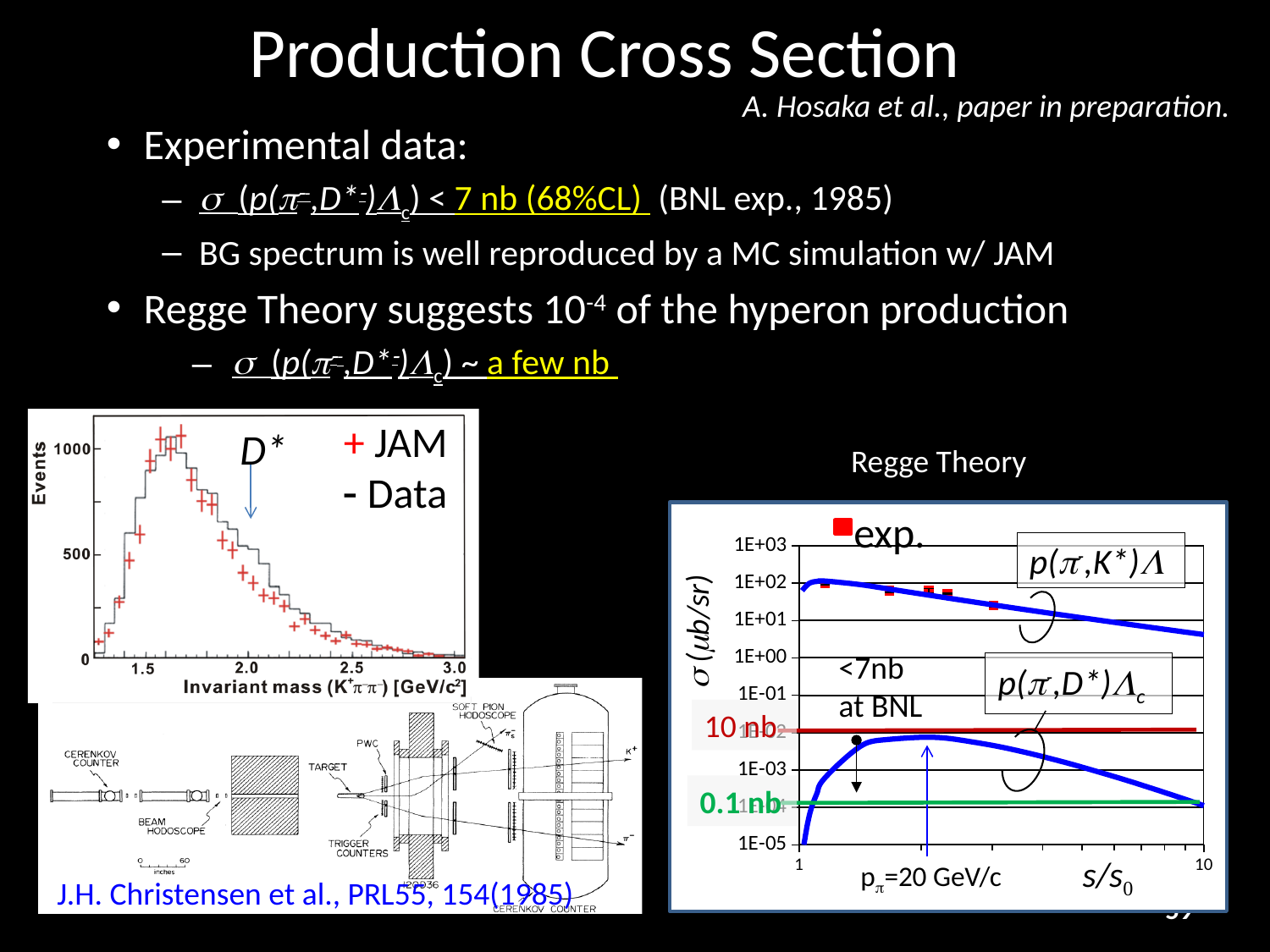
In the Regge Theory chart, which curve lies higher, p(π,K*)Λ or p(π,D*)Λc? p(π,K*)Λ In the Regge Theory chart, what cross-section value is labeled on the red horizontal line? 10 nb In the Regge Theory chart, what cross-section value is labeled on the green horizontal line? 0.1 nb In the Regge Theory chart, is the peak of the p(π,D*)Λc curve greater or less than 1E-01 μb/sr? less In the Regge Theory chart, what pion momentum is indicated by the arrow on the x axis? pπ=20 GeV/c In the Regge Theory chart, is the p(π,K*)Λ curve near s/s0 = 1 greater or less than 1E+01 μb/sr? greater In the left chart (Events vs invariant mass), is the peak number of events greater or less than 500? greater In the left chart (Events vs invariant mass), how do the event counts behave as the invariant mass increases from 1.5 to 3.0 GeV/c²? rise to a peak near 1.6-1.7 then fall In the left chart (Events vs invariant mass), how many series does the legend list? 2 What is the title of the chart on the right of the slide? Regge Theory In the Regge Theory chart, what upper limit is annotated for the BNL measurement? <7nb In the left chart (Events vs invariant mass), which symbol represents the JAM simulation? + (red crosses)